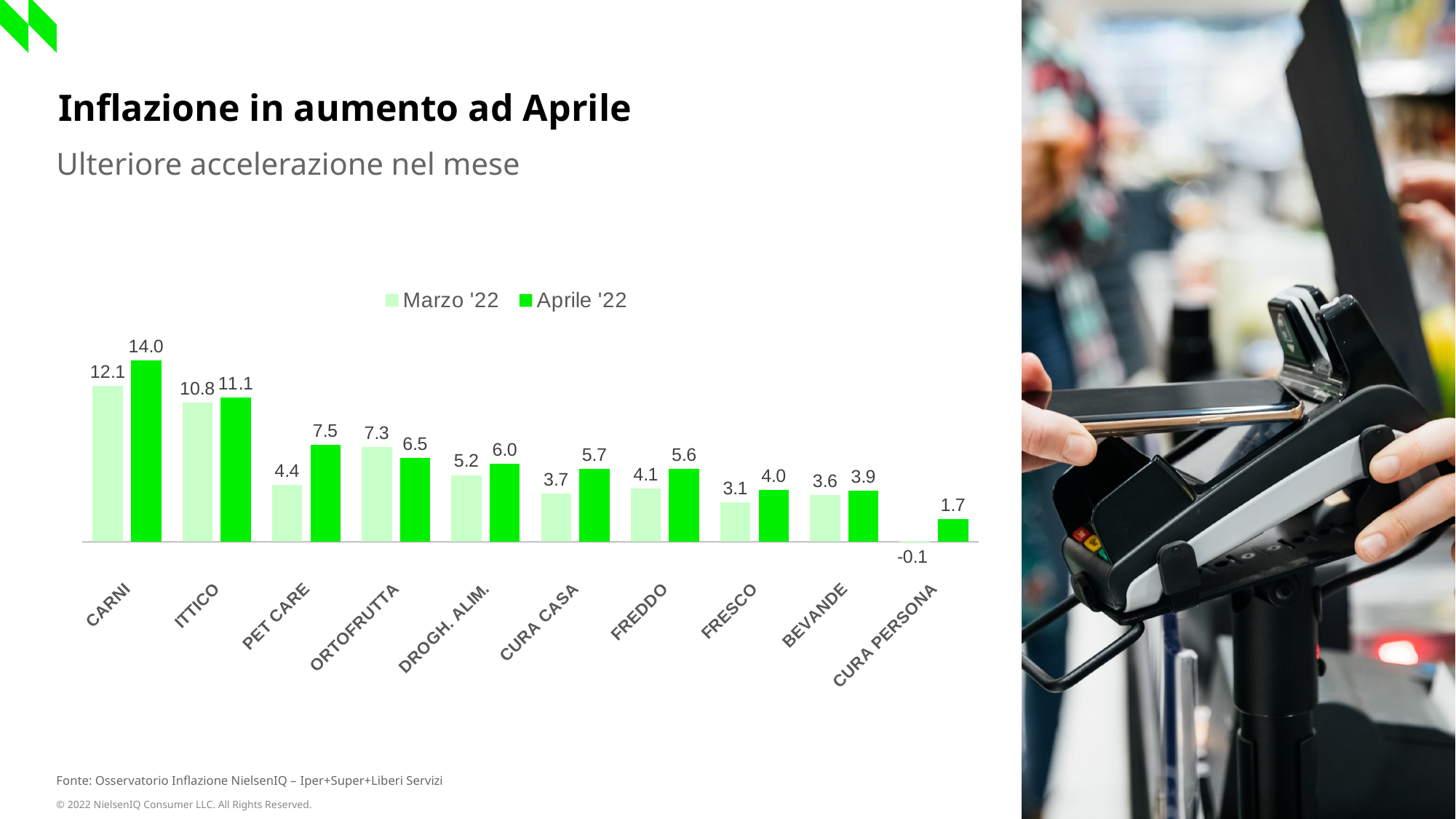
What are the two series named in the legend? Marzo '22 and Aprile '22 Which category has the lowest Marzo '22 value? CURA PERSONA What is the Marzo '22 value for CURA PERSONA? -0.1 For ORTOFRUTTA, which is larger: the Marzo '22 value or the Aprile '22 value? Marzo '22 What is the Marzo '22 value for PET CARE? 4.4 What is the Aprile '22 value for CARNI? 14.0 How many categories are shown on the x axis? 10 Which category has the highest Aprile '22 value? CARNI What is the difference between the Aprile '22 values for CARNI and ITTICO? 2.9 How many series does the legend list? 2 What kind of chart is shown on the slide? Bar chart What is the difference between the Aprile '22 and Marzo '22 values for PET CARE? 3.1